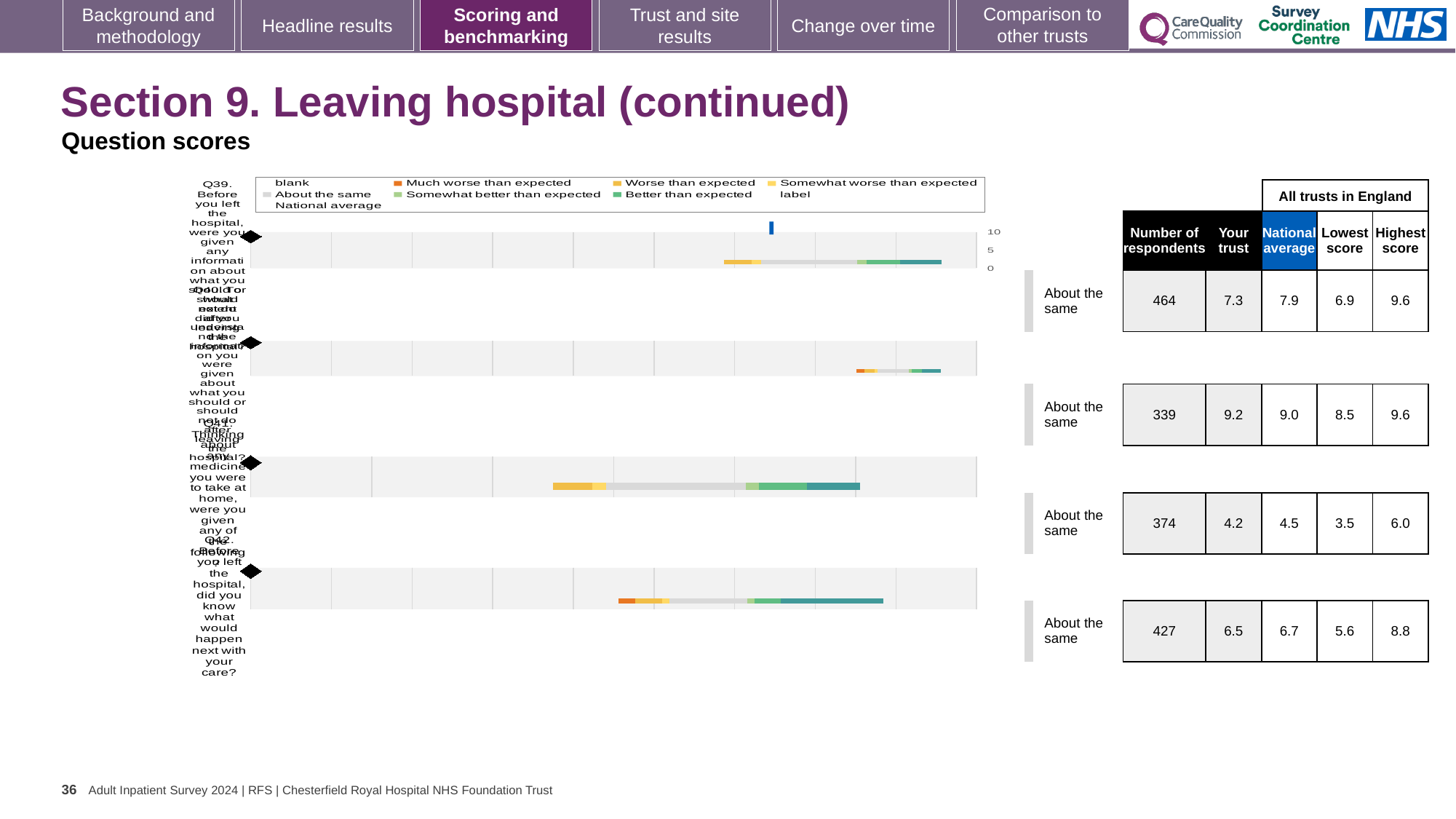
For the first question row, which is larger: the 'Your trust' score or the national average? National average For the second question row, what is the difference between the highest score and the lowest score? 1.1 How many entries does the chart legend list? 9 What is the highest score for the last question row (Q42)? 8.8 What is the 'Your trust' score for the last question row (Q42)? 6.5 How many question rows are plotted in the chart? 4 What is the number of respondents for the first question row (Q39)? 464 Which question row has the highest 'Your trust' score? Second row (9.2) Which question row has the lowest number of respondents? Second row (339) What is the national average for the third question row? 4.5 What kind of chart is used to show the question scores on this slide? Bar chart What benchmark category is shown for all four question rows? About the same